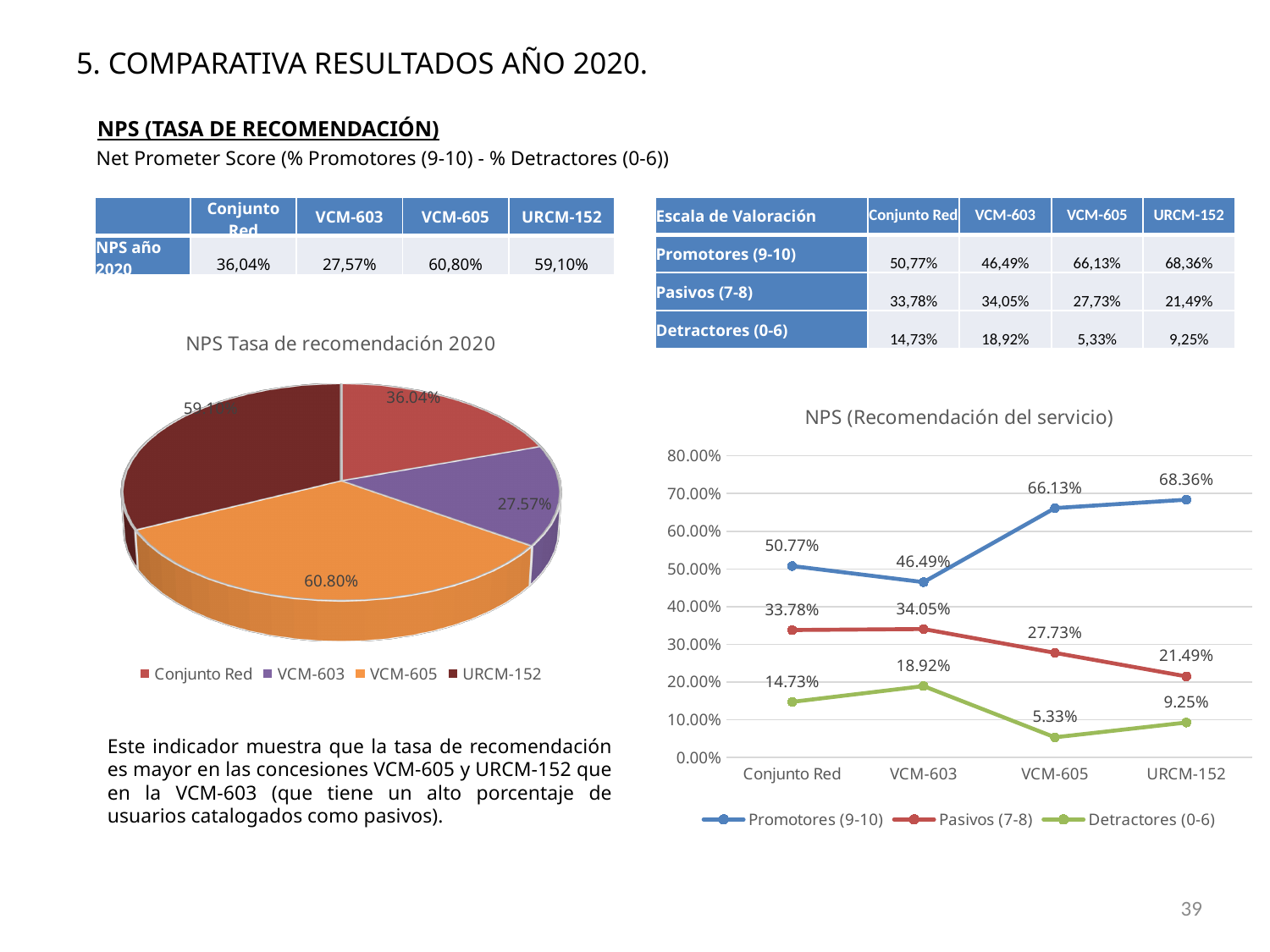
In the line chart 'NPS (Recomendación del servicio)', which category has the lowest Detractores (0-6) value? VCM-605 In the line chart 'NPS (Recomendación del servicio)', which category has the highest Promotores (9-10) value? URCM-152 In the line chart 'NPS (Recomendación del servicio)', does the Pasivos (7-8) series rise or fall from VCM-603 to URCM-152? Fall In the line chart 'NPS (Recomendación del servicio)', what is the Detractores (0-6) value for VCM-603? 18.92% In the pie chart 'NPS Tasa de recomendación 2020', what is the value for VCM-605? 60.80% In the line chart 'NPS (Recomendación del servicio)', what is the difference between the Promotores (9-10) values for URCM-152 and Conjunto Red? 17.59% What kind of chart is 'NPS (Recomendación del servicio)'? Line chart In the line chart 'NPS (Recomendación del servicio)', what is the Promotores (9-10) value for VCM-605? 66.13% In the pie chart 'NPS Tasa de recomendación 2020', which category has the smallest slice? VCM-603 How many series does the legend of the line chart 'NPS (Recomendación del servicio)' list? 3 What kind of chart is 'NPS Tasa de recomendación 2020'? Pie chart In the line chart 'NPS (Recomendación del servicio)', for VCM-605, which is larger: Pasivos (7-8) or Detractores (0-6)? Pasivos (7-8)